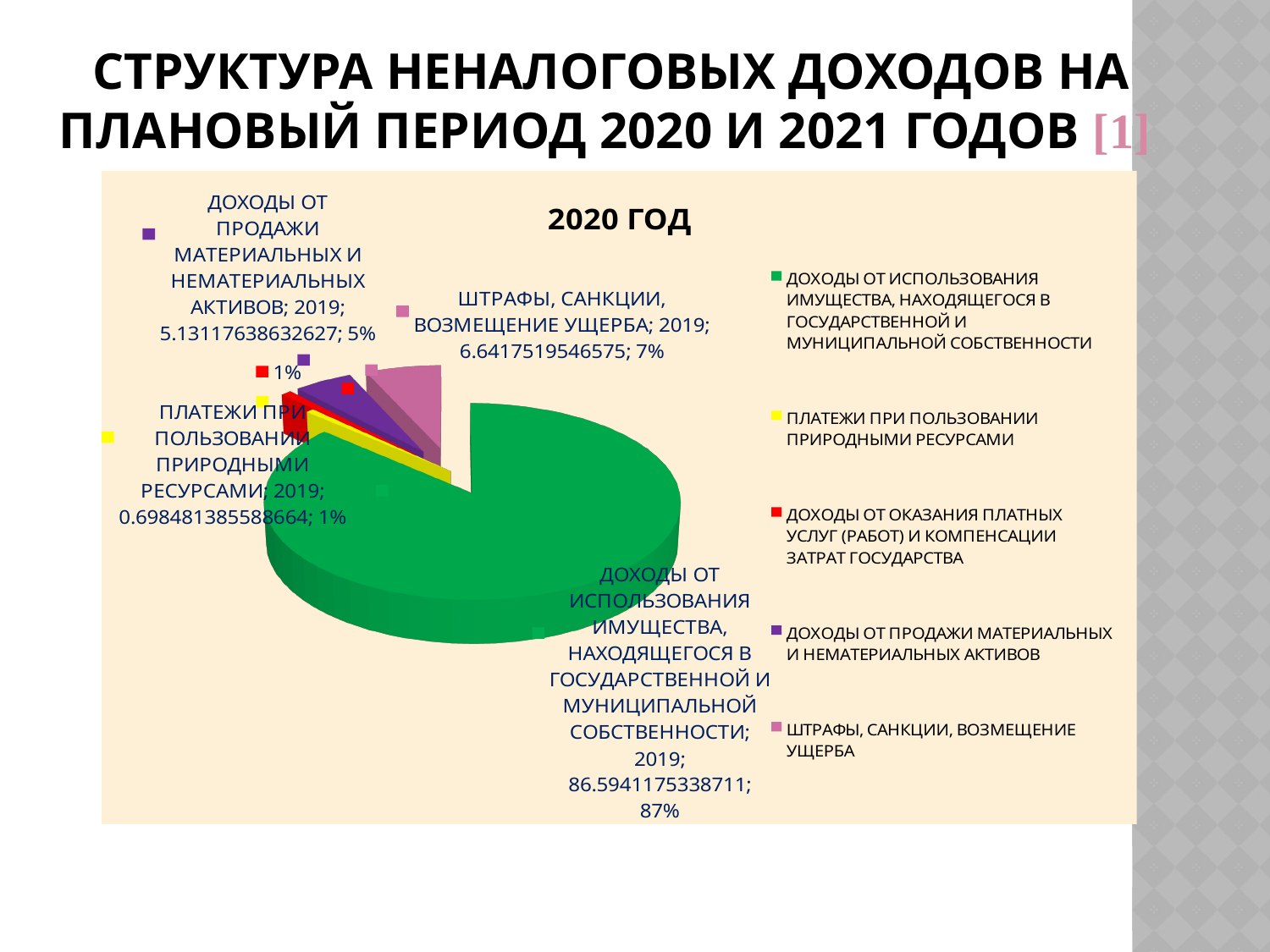
How many entries does the legend of the pie chart list? 5 What is the title shown above the pie chart? 2020 ГОД What percentage share does the slice ПЛАТЕЖИ ПРИ ПОЛЬЗОВАНИИ ПРИРОДНЫМИ РЕСУРСАМИ have? 1% What percentage share does the slice ШТРАФЫ, САНКЦИИ, ВОЗМЕЩЕНИЕ УЩЕРБА have? 7% What percentage share does the slice ДОХОДЫ ОТ ИСПОЛЬЗОВАНИЯ ИМУЩЕСТВА, НАХОДЯЩЕГОСЯ В ГОСУДАРСТВЕННОЙ И МУНИЦИПАЛЬНОЙ СОБСТВЕННОСТИ have? 87% Which category has the largest slice of the pie chart? ДОХОДЫ ОТ ИСПОЛЬЗОВАНИЯ ИМУЩЕСТВА, НАХОДЯЩЕГОСЯ В ГОСУДАРСТВЕННОЙ И МУНИЦИПАЛЬНОЙ СОБСТВЕННОСТИ What value is printed in the data label for ДОХОДЫ ОТ ПРОДАЖИ МАТЕРИАЛЬНЫХ И НЕМАТЕРИАЛЬНЫХ АКТИВОВ? 5.13117638632627 How many slices does the pie chart have? 5 Which slice is larger: ШТРАФЫ, САНКЦИИ, ВОЗМЕЩЕНИЕ УЩЕРБА or ДОХОДЫ ОТ ПРОДАЖИ МАТЕРИАЛЬНЫХ И НЕМАТЕРИАЛЬНЫХ АКТИВОВ? ШТРАФЫ, САНКЦИИ, ВОЗМЕЩЕНИЕ УЩЕРБА What value is printed in the data label for ШТРАФЫ, САНКЦИИ, ВОЗМЕЩЕНИЕ УЩЕРБА? 6.6417519546575 What kind of chart is shown on the slide? Pie chart